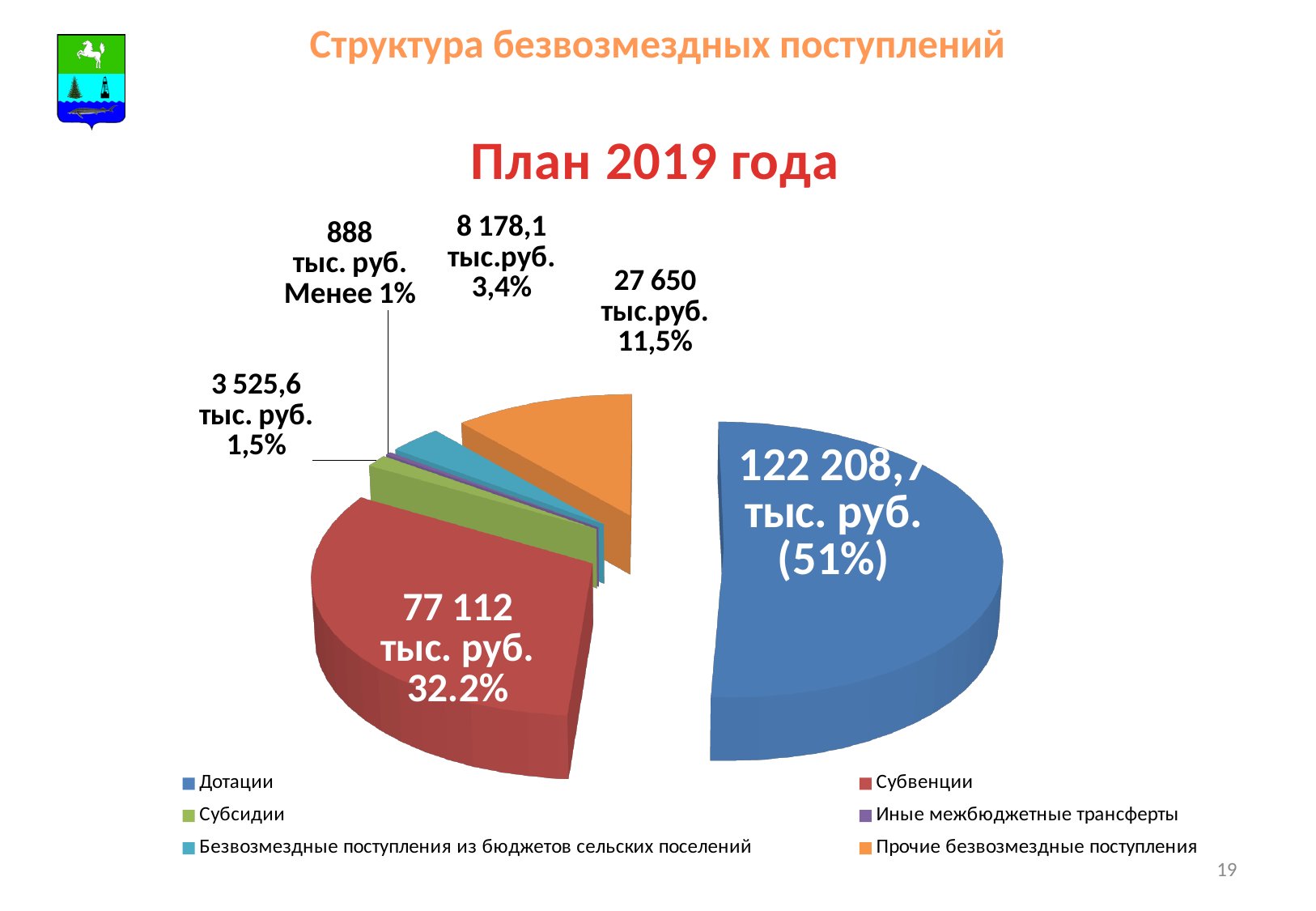
What is the value shown for Прочие безвозмездные поступления? 27 650 тыс.руб. What share of the pie does Прочие безвозмездные поступления account for? 11,5% What is the value shown for Иные межбюджетные трансферты? 888 тыс. руб. What share of the pie does Дотации account for? 51% What is the value shown for Безвозмездные поступления из бюджетов сельских поселений? 8 178,1 тыс.руб. How many categories does the legend of the pie chart list? 6 What is the value shown for Субвенции? 77 112 тыс. руб. What type of chart is shown on the slide? Pie chart Which category has the largest slice of the pie? Дотации What share of the pie does Субвенции account for? 32.2% Which is larger, the value for Субвенции or the value for Прочие безвозмездные поступления? Субвенции What is the value shown for Субсидии? 3 525,6 тыс. руб.